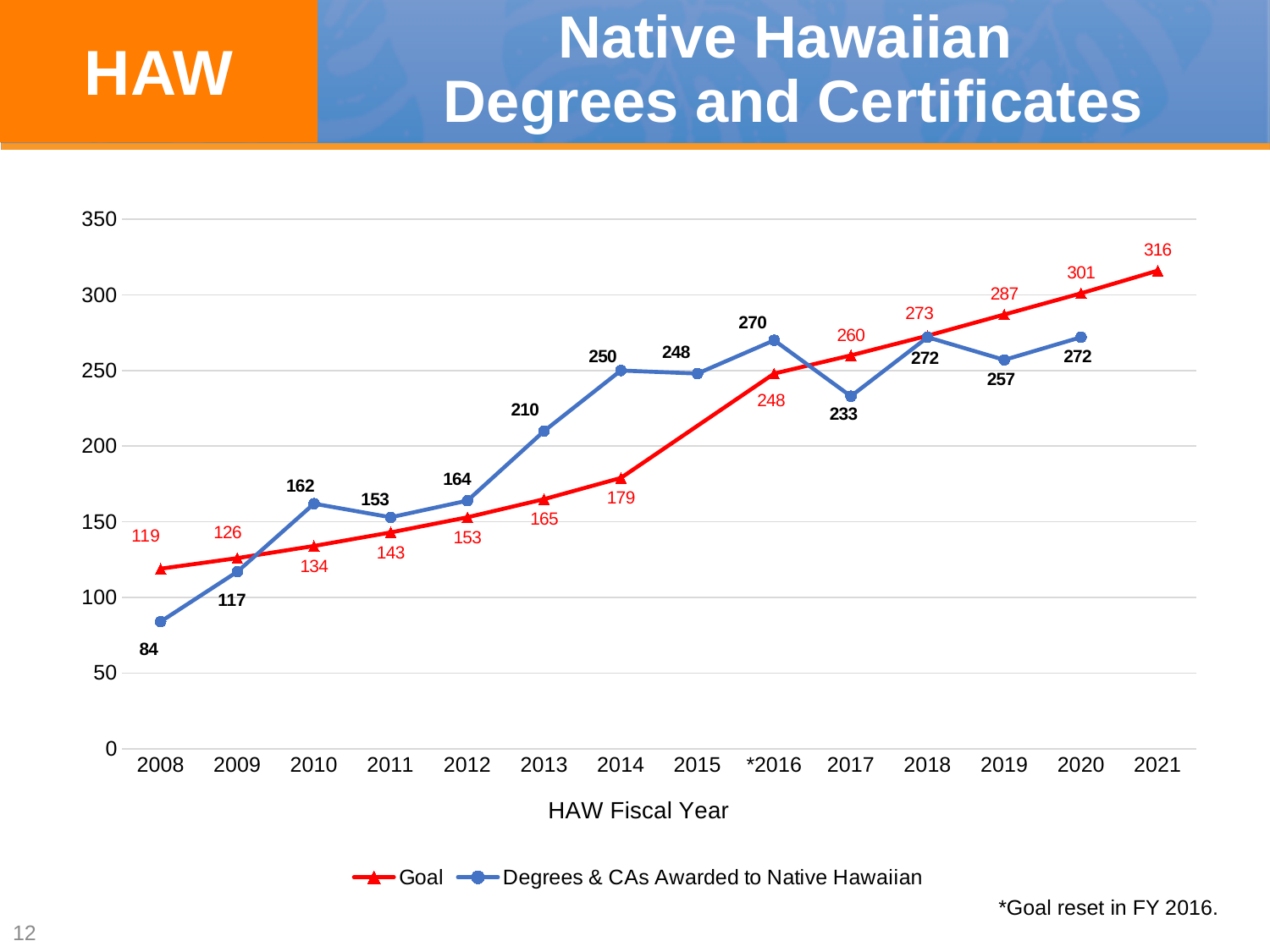
What is the value of Degrees & CAs Awarded to Native Hawaiian in 2017? 233 Which is larger in 2014, the Goal or the Degrees & CAs Awarded to Native Hawaiian? Degrees & CAs Awarded to Native Hawaiian In which year is the Degrees & CAs Awarded to Native Hawaiian value lowest? 2008 What is the Goal value for 2012? 153 What kind of chart is shown on the slide? Line chart What is the difference between the Goal and the Degrees & CAs Awarded to Native Hawaiian in 2019? 30 What is the Goal value for 2021? 316 What is the value of Degrees & CAs Awarded to Native Hawaiian in 2008? 84 How many fiscal years are shown on the x axis? 14 Is the Degrees & CAs Awarded to Native Hawaiian value for 2013 greater or less than 200? greater Does the Goal series rise or fall from 2008 to 2021? Rise How many series does the legend list? 2